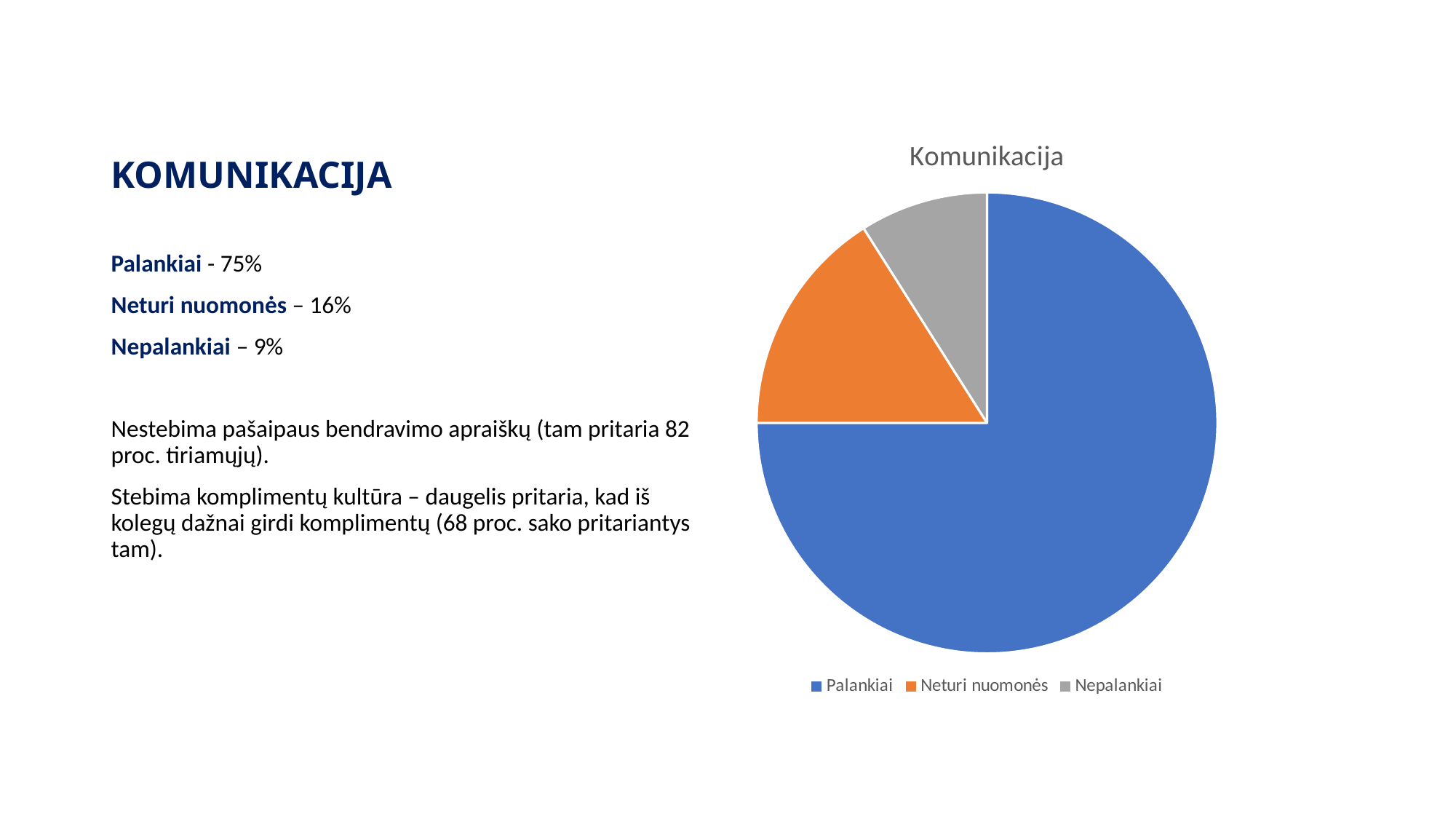
How many entries does the chart legend list? 3 What colour is the Palankiai slice in the pie chart? blue What share of the pie does Neturi nuomonės represent? 16% Which slice is larger, Neturi nuomonės or Nepalankiai? Neturi nuomonės Which category has the smallest slice of the pie? Nepalankiai What is the difference in percentage points between Palankiai and Neturi nuomonės? 59 Which category has the largest slice of the pie? Palankiai How many slices does the pie chart have? 3 What share of the pie does Palankiai represent? 75% What is the title of the chart? Komunikacija What share of the pie does Nepalankiai represent? 9% What kind of chart is shown on the slide? pie chart